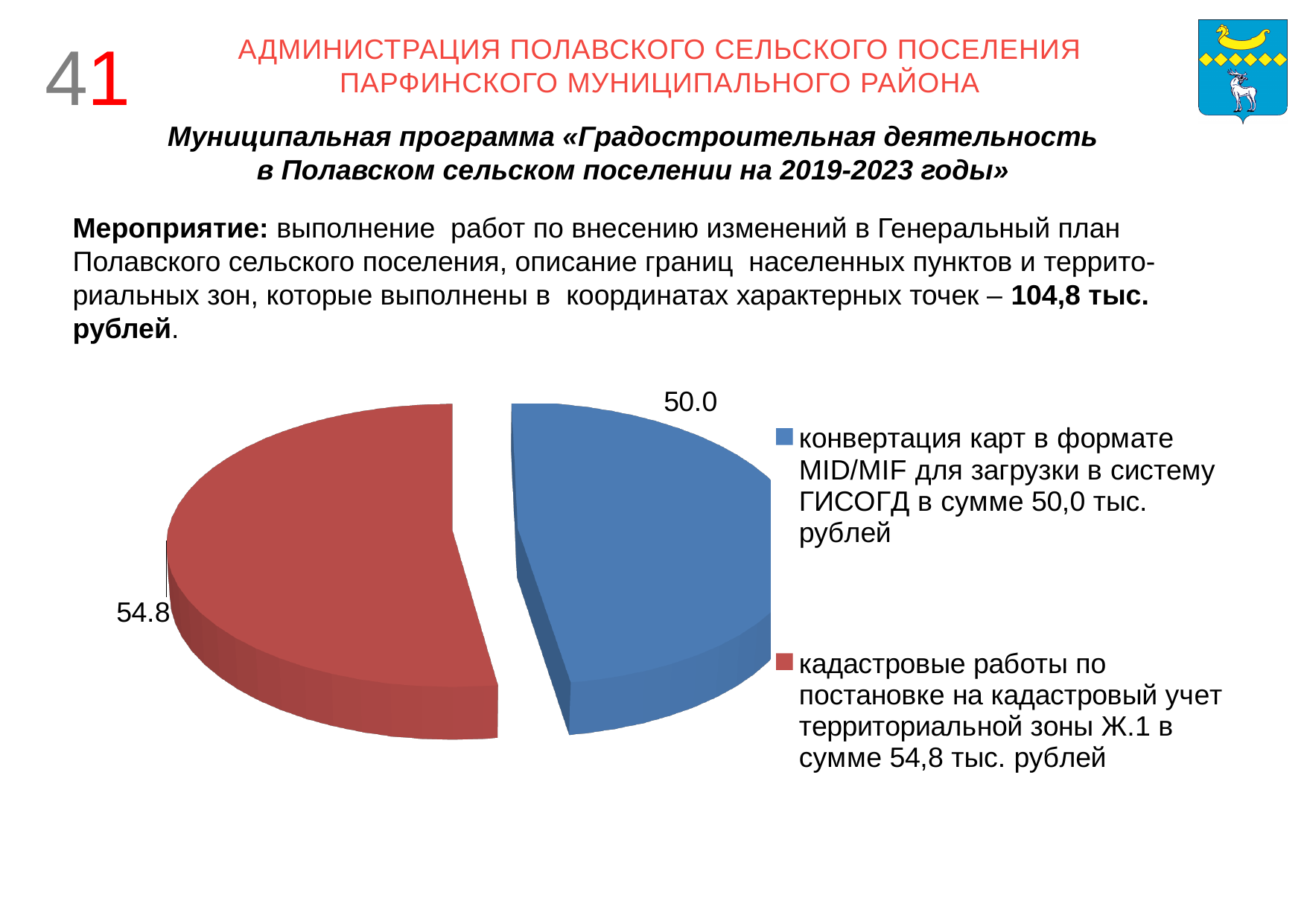
How many entries does the legend of the pie chart list? 2 What is the value of the slice for «кадастровые работы по постановке на кадастровый учет территориальной зоны Ж.1»? 54.8 Which is larger: the slice for конвертация карт в формате MID/MIF or the slice for кадастровые работы по постановке на кадастровый учет? кадастровые работы по постановке на кадастровый учет How many slices does the pie chart have? 2 What is the total of the two slices in the pie chart? 104.8 Which slice of the pie chart is the largest? кадастровые работы по постановке на кадастровый учет территориальной зоны Ж.1 What is the difference between the value for кадастровые работы (54.8) and the value for конвертация карт (50.0)? 4.8 What colour is the slice for «конвертация карт в формате MID/MIF для загрузки в систему ГИСОГД»? blue What colour is the slice for «кадастровые работы по постановке на кадастровый учет территориальной зоны Ж.1»? red What kind of chart is shown on the slide? pie chart What is the value of the slice for «конвертация карт в формате MID/MIF для загрузки в систему ГИСОГД»? 50.0 Which slice of the pie chart is the smallest? конвертация карт в формате MID/MIF для загрузки в систему ГИСОГД